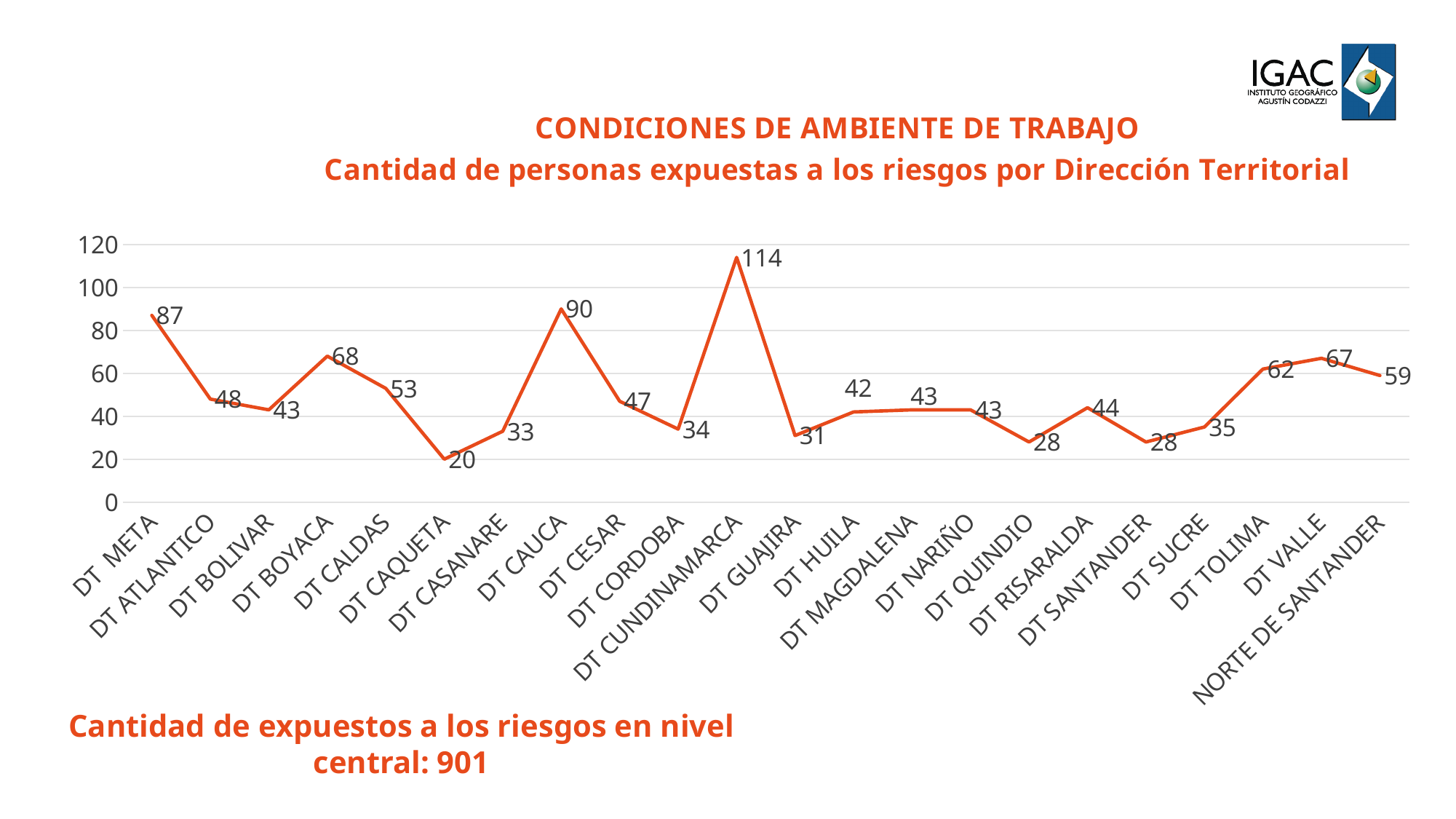
What is the value for DT VALLE? 67 Which Dirección Territorial has the lowest number of exposed persons? DT CAQUETA How many Direcciones Territoriales are plotted on the chart? 22 What is the number of exposed persons at the central level stated on the slide? 901 Which Dirección Territorial has the highest number of exposed persons? DT CUNDINAMARCA What is the difference between the values for DT CUNDINAMARCA and DT CAUCA? 24 What is the value for DT CUNDINAMARCA? 114 Which has a larger value, DT BOYACA or DT TOLIMA? DT BOYACA Is the value for DT CAUCA greater or less than 80? greater What is the value for DT CAQUETA? 20 What is the difference between the values for DT META and DT ATLANTICO? 39 What kind of chart is shown on the slide? Line chart